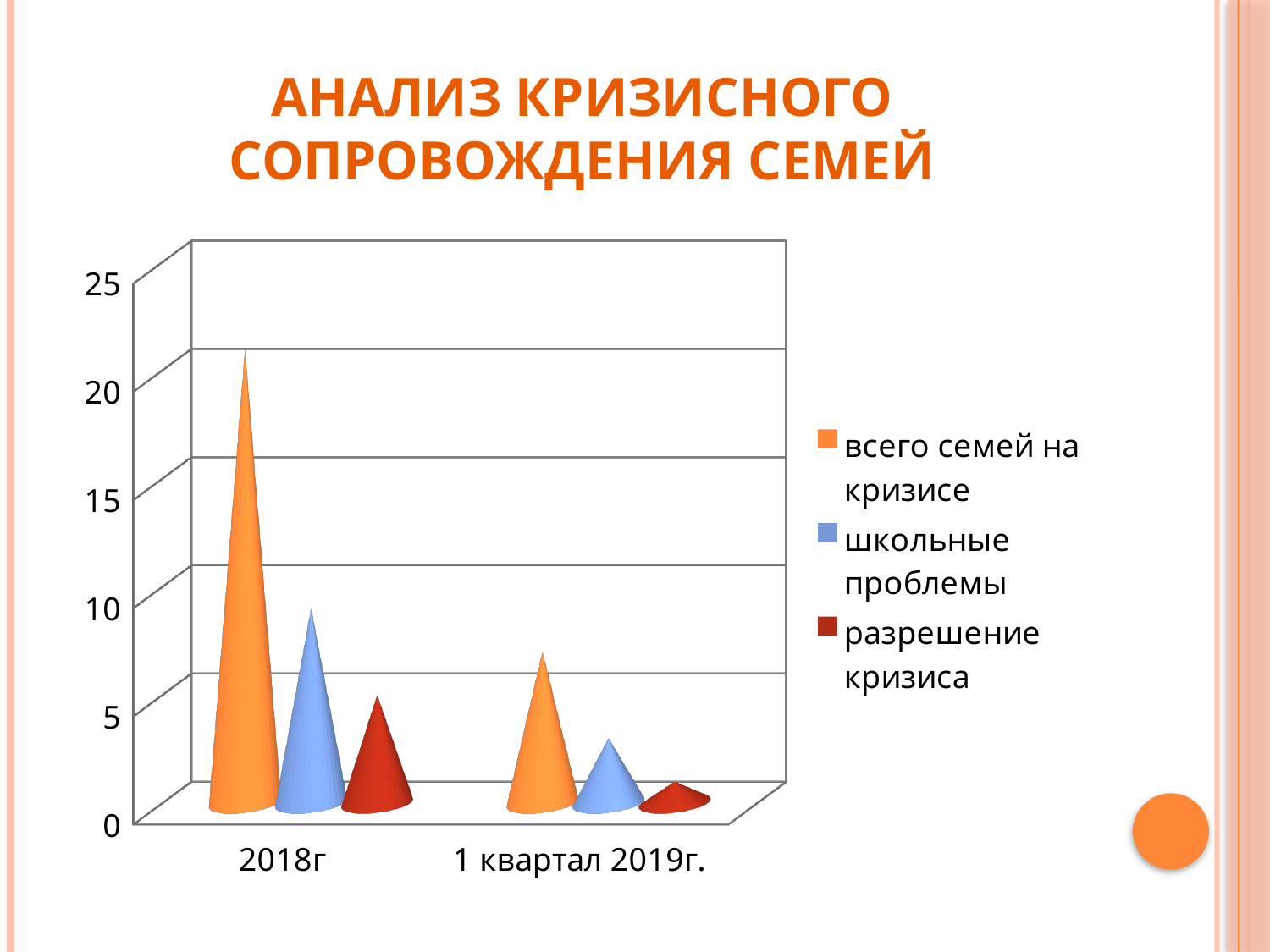
What kind of chart is shown on the slide? bar chart How many series does the legend list? 3 Which is larger: всего семей на кризисе in 2018г or in 1 квартал 2019г.? 2018г Is the value for всего семей на кризисе in 1 квартал 2019г. greater or less than 10? less Is the value for всего семей на кризисе in 2018г greater or less than 15? greater How many categories are shown on the x axis? 2 What colour represents разрешение кризиса in the legend? dark red Which series has the lowest value in 1 квартал 2019г.? разрешение кризиса Is the value for школьные проблемы in 1 квартал 2019г. greater or less than 5? less Which series has the highest value in 2018г? всего семей на кризисе Do the values for всего семей на кризисе rise or fall from 2018г to 1 квартал 2019г.? fall